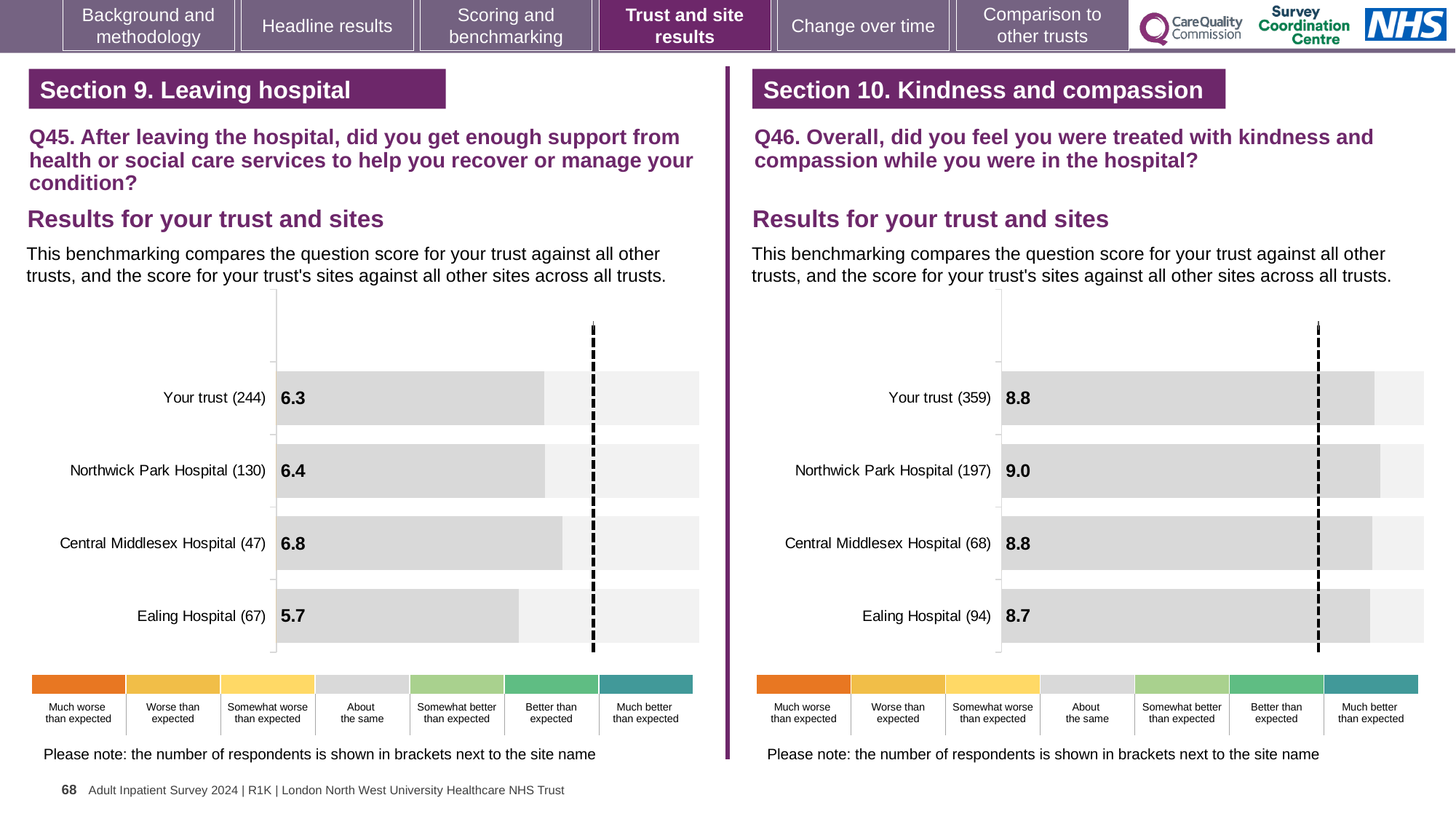
On the Q45 chart (left), what is the score for Ealing Hospital? 5.7 On the Q45 chart (left), which site has the lowest score? Ealing Hospital On the Q46 chart (right), how many bars are plotted? 4 On the Q46 chart (right), what is the score for Ealing Hospital? 8.7 On the Q46 chart (right), what is the score for Northwick Park Hospital? 9.0 What kind of chart is used on the Q45 chart (left)? Bar chart On the Q46 chart (right), how many respondents are shown in brackets for Your trust? 359 On the Q45 chart (left), which site has the highest score? Central Middlesex Hospital On the Q46 chart (right), which is larger, the score for Northwick Park Hospital or the score for Ealing Hospital? Northwick Park Hospital On the Q45 chart (left), what is the difference between the scores for Central Middlesex Hospital and Ealing Hospital? 1.1 On the Q46 chart (right), which site has the highest score? Northwick Park Hospital On the Q45 chart (left), what is the score for Your trust? 6.3